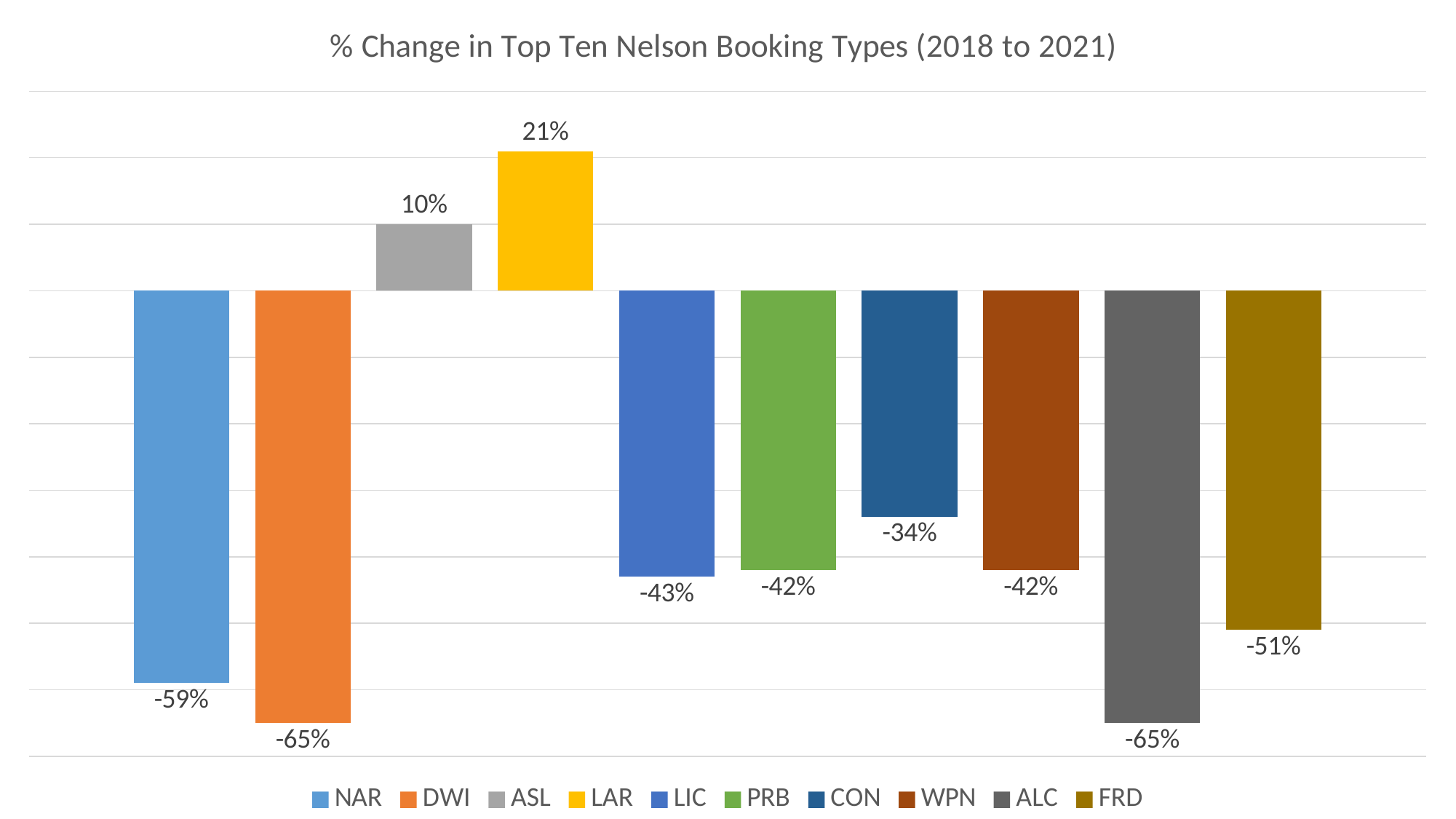
Which booking type has the highest % change? LAR What is the value for CON? -34% What is the value for DWI? -65% Which is larger, the value for CON or the value for LIC? CON What is the difference between the values for LAR and ASL? 11 percentage points What is the value for FRD? -51% What is the value for LAR? 21% What is the title of the chart? % Change in Top Ten Nelson Booking Types (2018 to 2021) What kind of chart is shown on the slide? Bar chart What is the difference between the values for CON and FRD? 17 percentage points How many entries does the legend list? 10 How many booking types are shown in the chart? 10